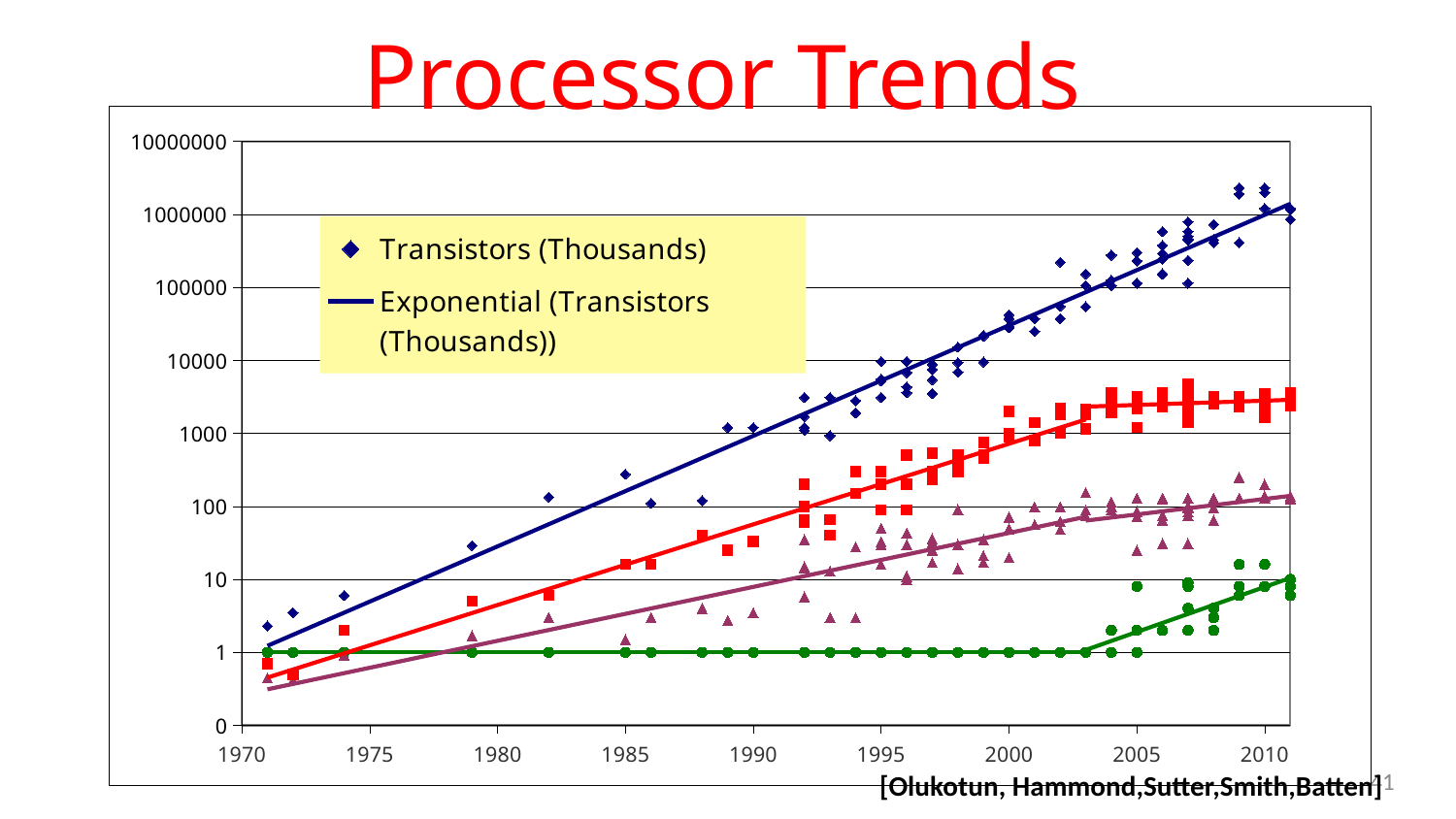
Is the value of the green circle series plotted for 1990 greater or less than 10? less What is the first year labelled on the x axis? 1970 What kind of chart is shown on the slide? scatter chart What is the title of the slide containing the chart? Processor Trends Do the Transistors (Thousands) values rise or fall as the years increase along the x axis? rise Are the Transistors (Thousands) values plotted around 2005 greater or less than 10000? greater What colour and marker shape represent the Transistors (Thousands) series in the legend? blue diamonds What is the last year labelled on the x axis? 2010 What is the highest value labelled on the y axis? 10000000 How many series does the chart legend list? 2 Is the Transistors (Thousands) value plotted for 1985 greater or less than 1000? less